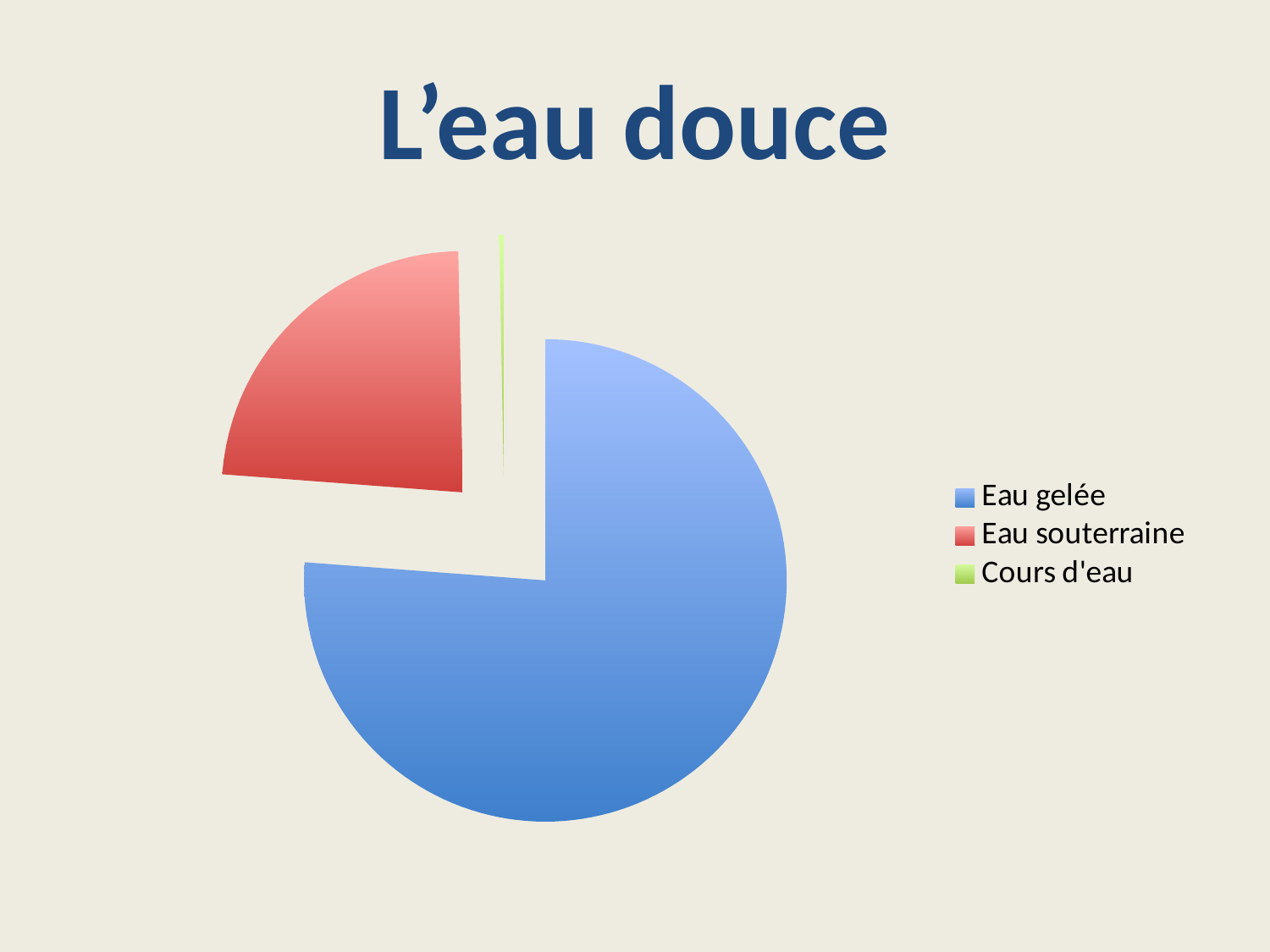
Which slice is smaller, Eau gelée or Cours d'eau? Cours d'eau How many categories does the pie chart have? 3 Which slice is larger, Eau gelée or Eau souterraine? Eau gelée Which category is shown in blue in the pie chart? Eau gelée What is the title of the slide containing the pie chart? L'eau douce Which category has the smallest slice of the pie chart? Cours d'eau Which category has the largest slice of the pie chart? Eau gelée Which slice is larger, Eau souterraine or Cours d'eau? Eau souterraine What kind of chart is shown on the slide? Pie chart What colour is the Eau souterraine slice in the pie chart? Red